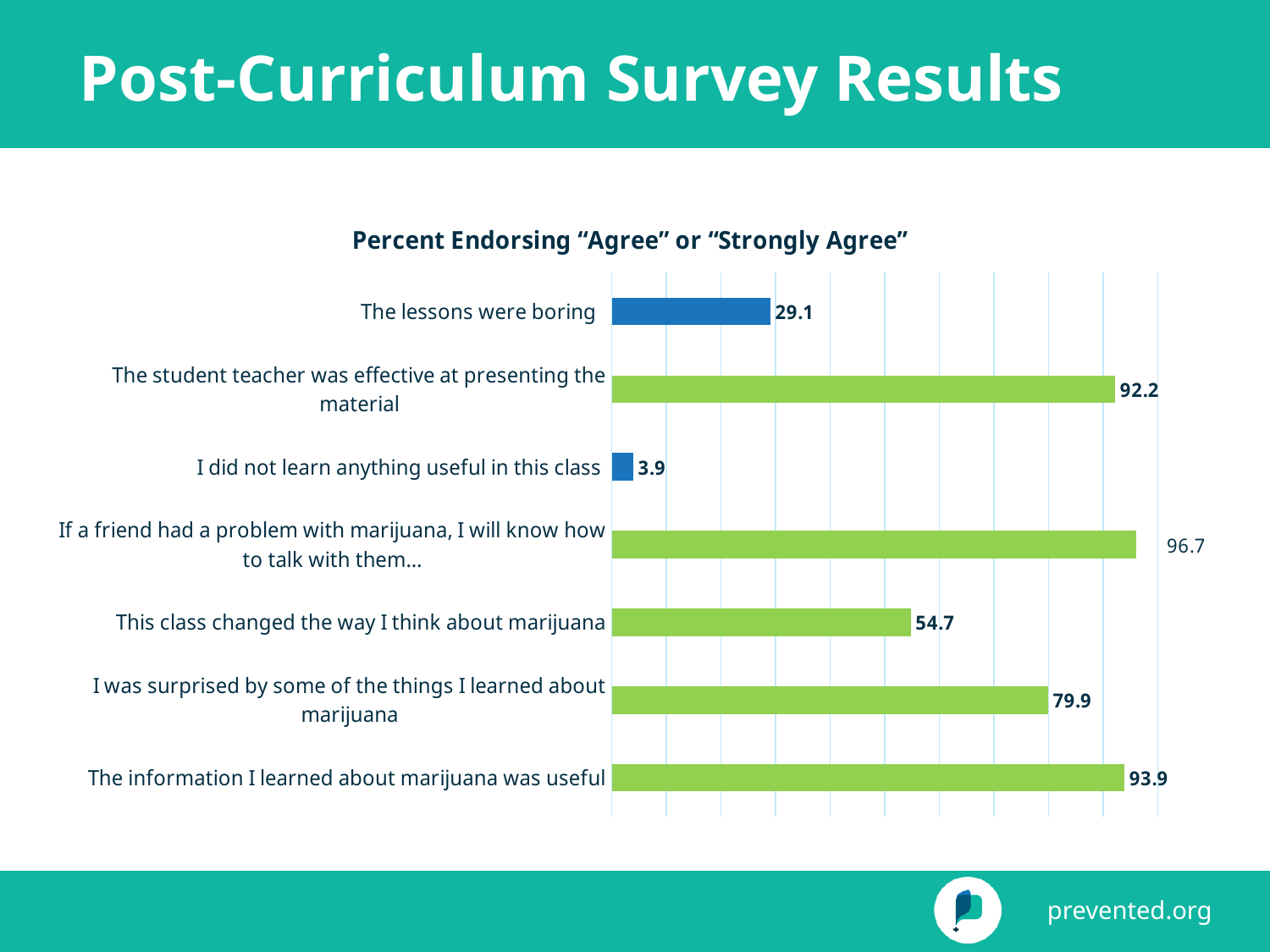
How many survey statements (categories) are plotted in the chart? 7 What kind of chart is shown on the slide? bar chart What is the value for "The student teacher was effective at presenting the material"? 92.2 What is the value for "This class changed the way I think about marijuana"? 54.7 Which statement has the highest value? If a friend had a problem with marijuana, I will know how to talk with them... What is the value for "I did not learn anything useful in this class"? 3.9 What is the chart's title? Percent Endorsing "Agree" or "Strongly Agree" What is the difference between the values for "The information I learned about marijuana was useful" and "I was surprised by some of the things I learned about marijuana"? 14.0 Which is larger: the value for "This class changed the way I think about marijuana" or the value for "The lessons were boring"? This class changed the way I think about marijuana What is the value for "The information I learned about marijuana was useful"? 93.9 Which statement has the lowest value? I did not learn anything useful in this class What is the value for "The lessons were boring"? 29.1